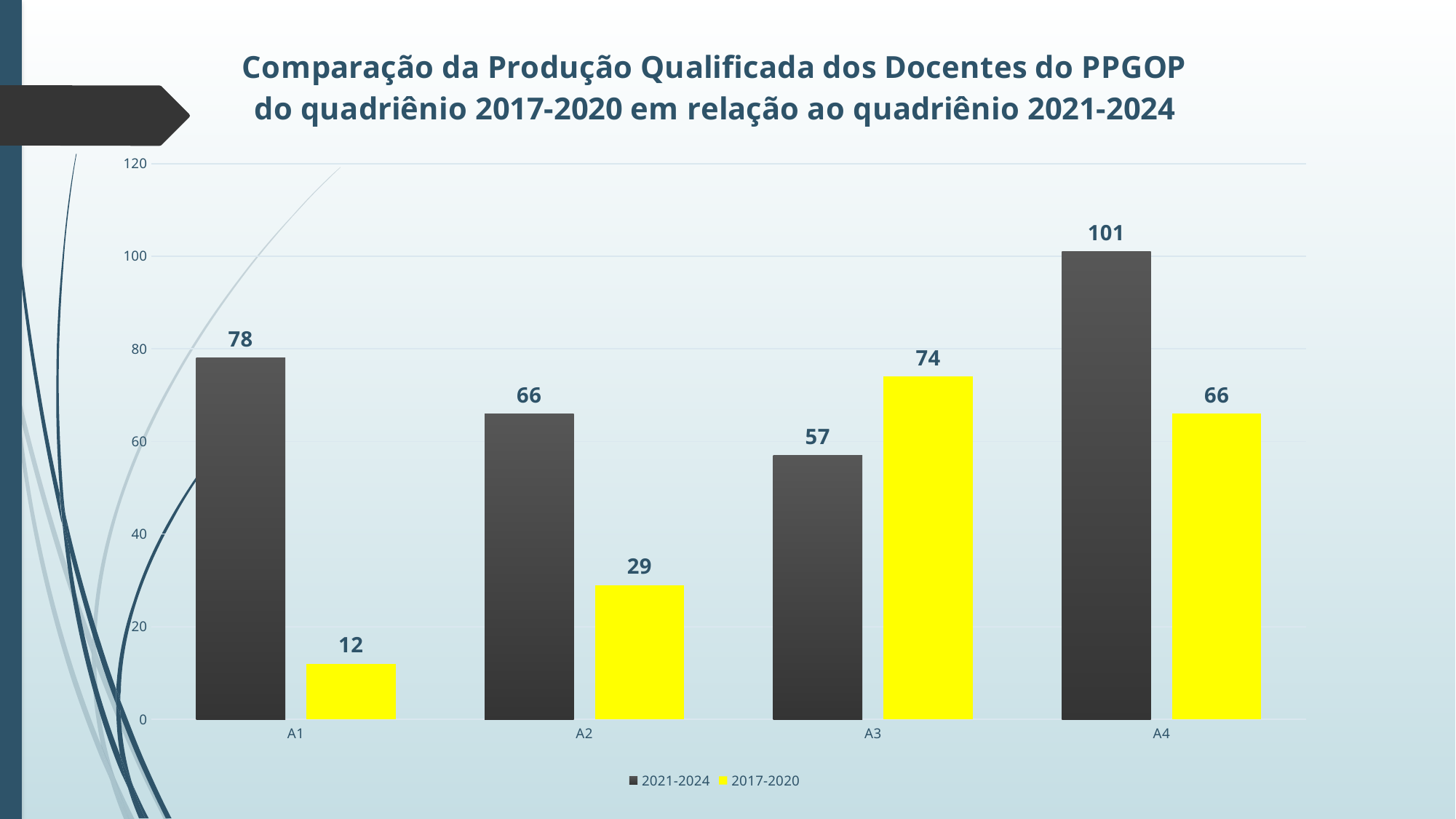
How many series does the legend list? 2 What is the value for A4 in the 2021-2024 series? 101 What is the difference between the 2021-2024 and 2017-2020 values for A4? 35 What is the difference between the 2021-2024 and 2017-2020 values for A1? 66 Which category has the lowest value in the 2017-2020 series? A1 What is the value for A3 in the 2017-2020 series? 74 What kind of chart is shown on the slide? Bar chart Which colour represents the 2017-2020 series? Yellow How many categories are shown on the x axis? 4 Which category has the highest value in the 2021-2024 series? A4 For A3, which series has the larger value, 2021-2024 or 2017-2020? 2017-2020 What is the value for A1 in the 2021-2024 series? 78